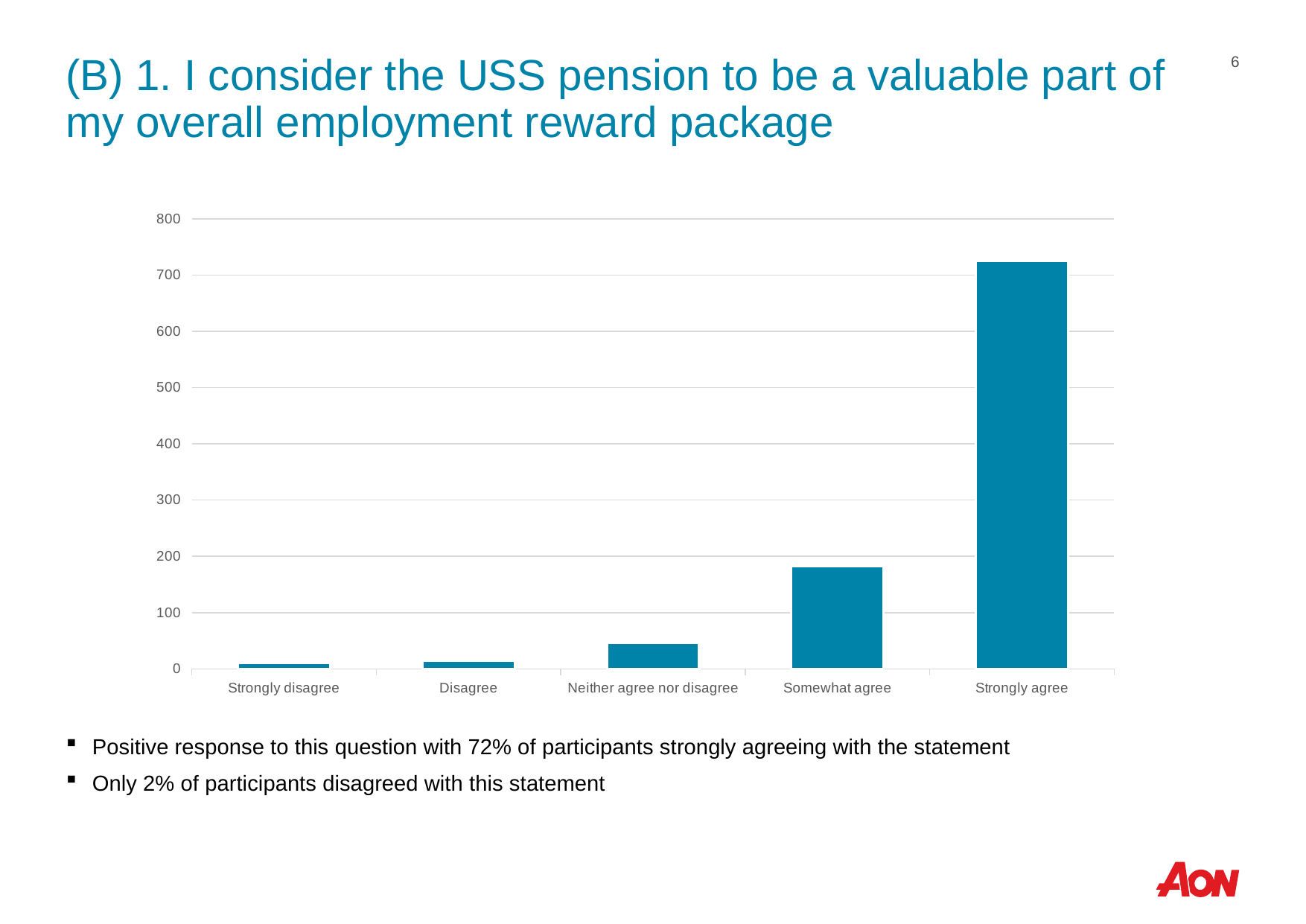
Is the value for Neither agree nor disagree greater or less than 100? less What is the highest value shown on the y axis? 800 Is the value for Somewhat agree greater or less than 200? less Is the value for Strongly agree greater or less than 700? greater Which response category has the lowest bar? Strongly disagree Which response category has the highest bar? Strongly agree Do the values rise or fall moving from Strongly disagree to Strongly agree along the x axis? Rise What kind of chart is shown on the slide? Bar chart What is the label of the category between Disagree and Somewhat agree? Neither agree nor disagree Which is larger, the value for Somewhat agree or the value for Neither agree nor disagree? Somewhat agree How many response categories are shown on the x axis? 5